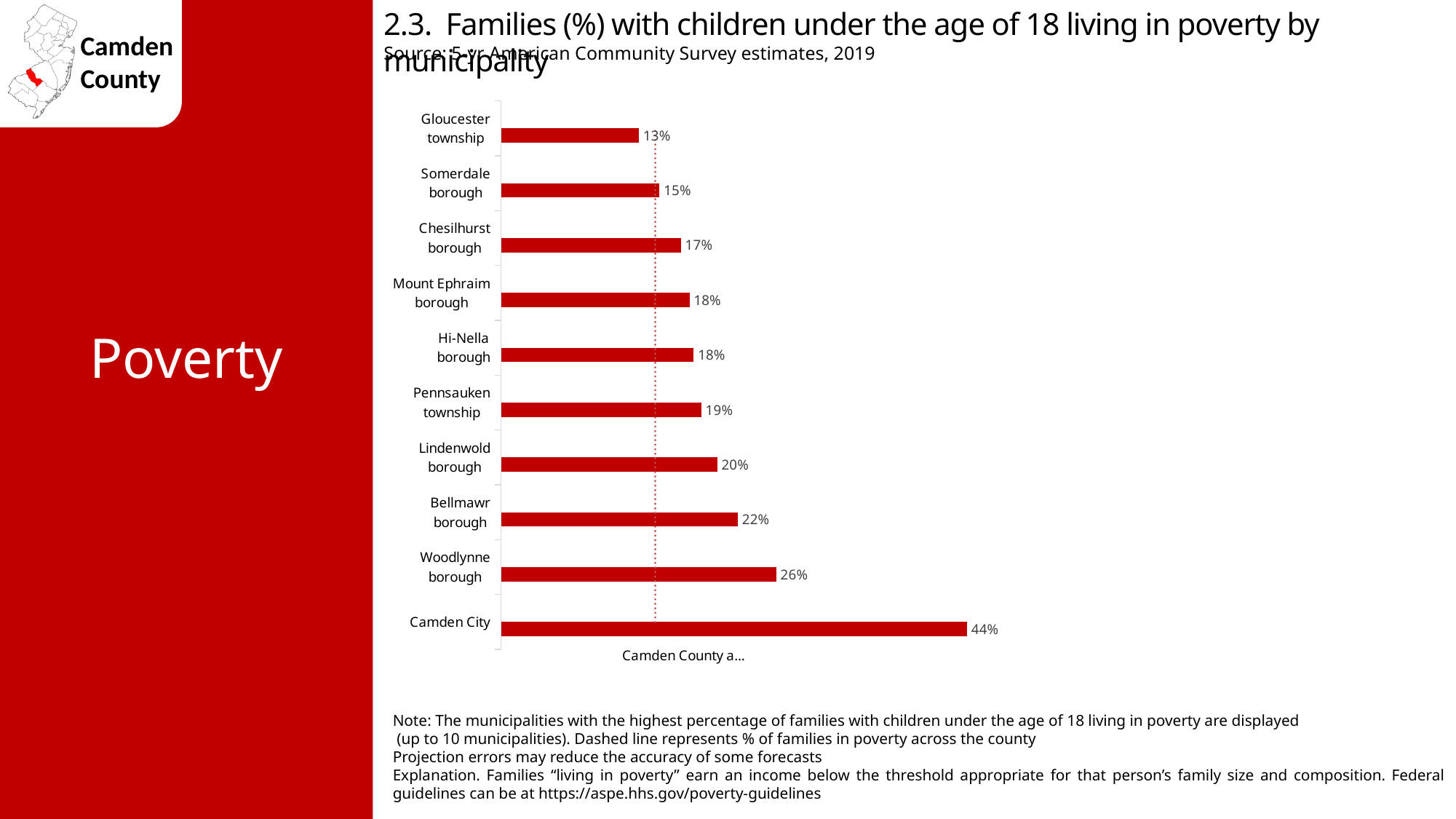
What is the value shown for Woodlynne borough? 26% How many municipalities are shown on the chart? 10 What is the value shown for Gloucester township? 13% What type of chart is used on this slide? Bar chart What is the difference in percentage points between Camden City and Woodlynne borough? 18 Which has a higher value, Lindenwold borough or Chesilhurst borough? Lindenwold borough Which municipality has the lowest percentage shown on the chart? Gloucester township What is the value shown for Pennsauken township? 19% What is the difference in percentage points between Bellmawr borough and Somerdale borough? 7 What percentage of families with children under 18 are living in poverty in Camden City? 44% Which municipality has the highest percentage of families with children under 18 living in poverty? Camden City What does the dashed vertical line on the chart represent? % of families in poverty across the county